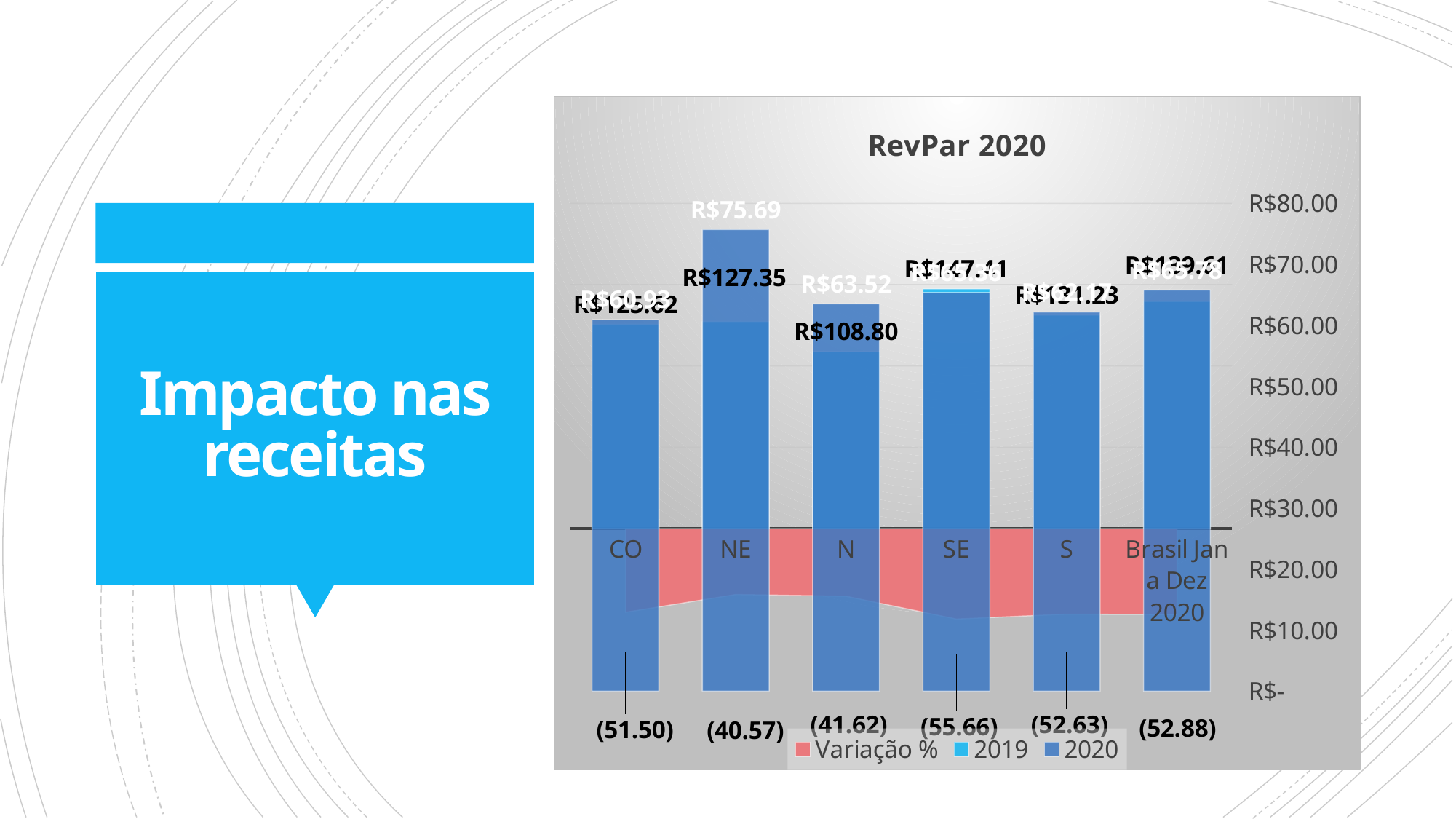
What is the difference between the 2019 and 2020 values for NE? R$51.66 How many series does the chart legend list? 3 What is the Variação % value for SE? (55.66) What is the 2019 value for NE? R$127.35 What is the 2019 value for N? R$108.80 What is the 2020 value for NE? R$75.69 What kind of chart is shown on the slide? bar chart How many categories are shown on the x axis of the chart? 6 What is the Variação % value for CO? (51.50) Which category has the highest 2020 value? NE What is the 2020 value for N? R$63.52 What is the title of the chart? RevPar 2020